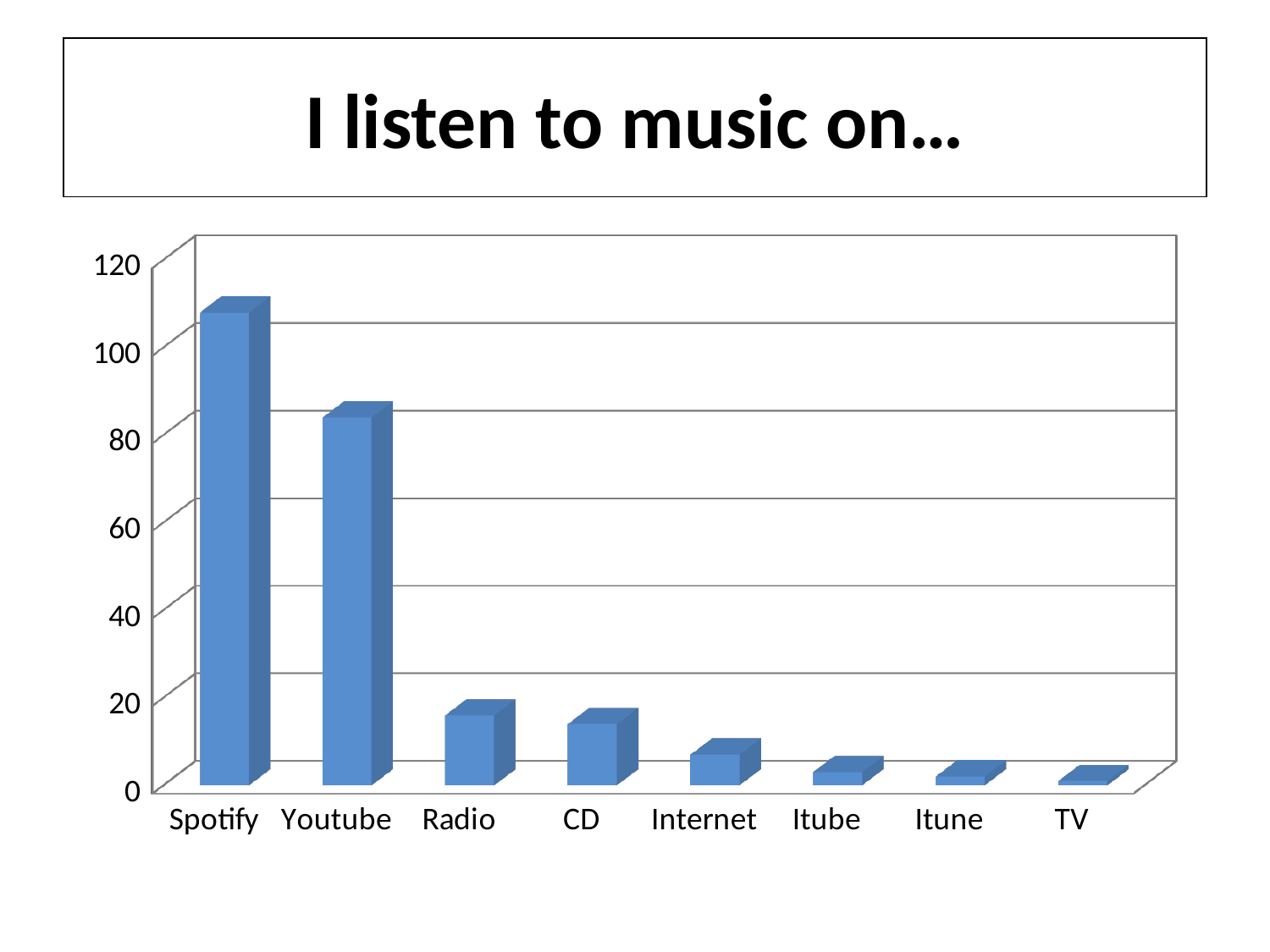
What kind of chart is shown on the slide? bar chart Do the values generally rise or fall from left to right along the x axis? fall Is the value for Spotify greater or less than 100? greater Is the value for Radio greater or less than 20? less What is the title of the slide containing the chart? I listen to music on… Is the value for Internet greater or less than 20? less How many categories are shown on the x axis of the chart? 8 Which is larger, the value for Spotify or the value for Youtube? Spotify Which is larger, the value for Radio or the value for Internet? Radio Which category has the highest value in the chart? Spotify